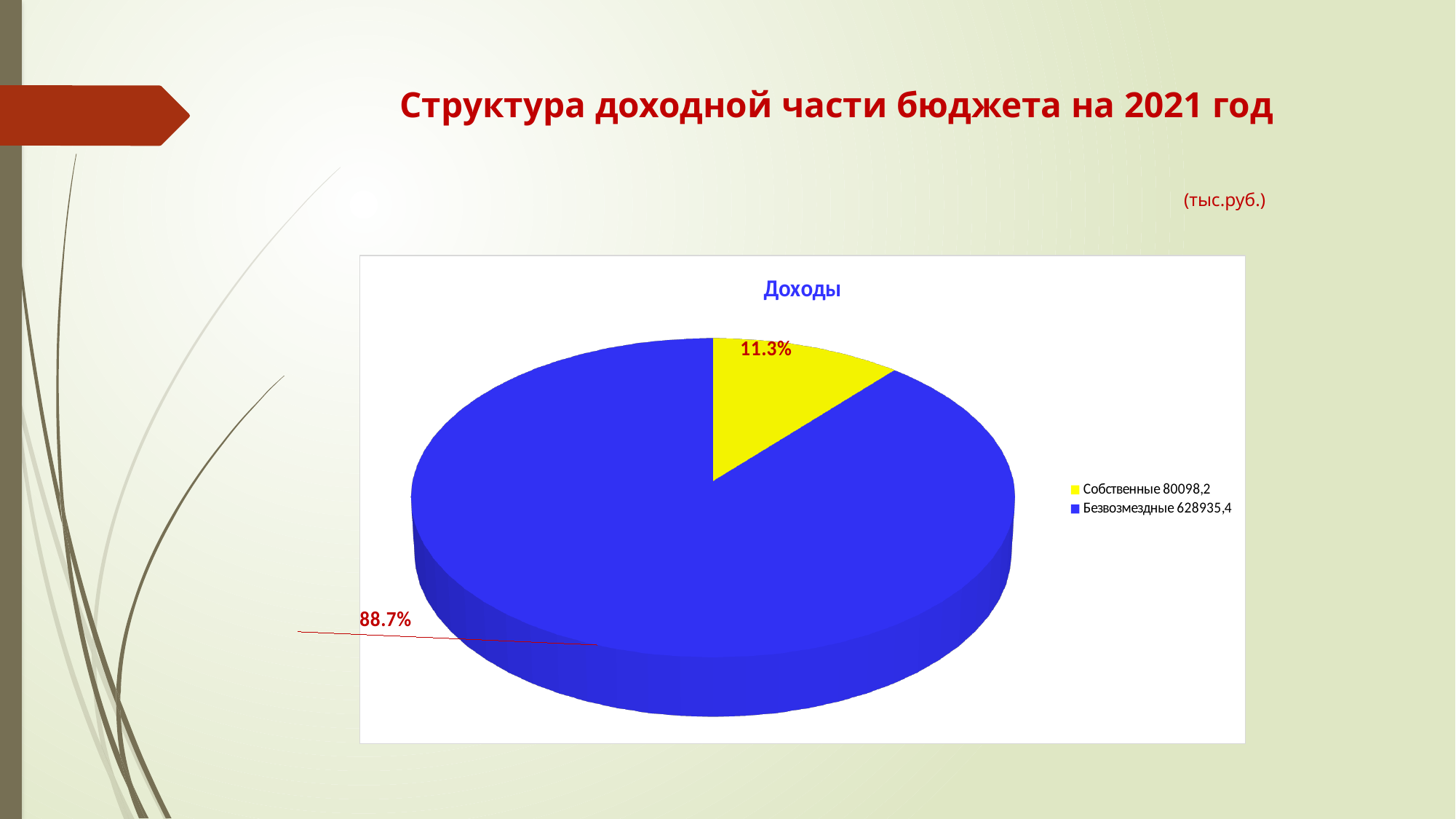
What share of the pie does the Безвозмездные slice represent? 88.7% What value is shown in the legend for Собственные? 80098,2 What is the title of the chart? Доходы Which category has the largest slice of the pie? Безвозмездные What colour is the Собственные slice? yellow How many slices does the pie chart have? 2 What kind of chart is shown on the slide? pie chart Which is larger, the Собственные slice or the Безвозмездные slice? Безвозмездные What share of the pie does the Собственные slice represent? 11.3% What is the difference in percentage points between the Безвозмездные and Собственные shares? 77.4 What value is shown in the legend for Безвозмездные? 628935,4 Which category has the smallest slice of the pie? Собственные